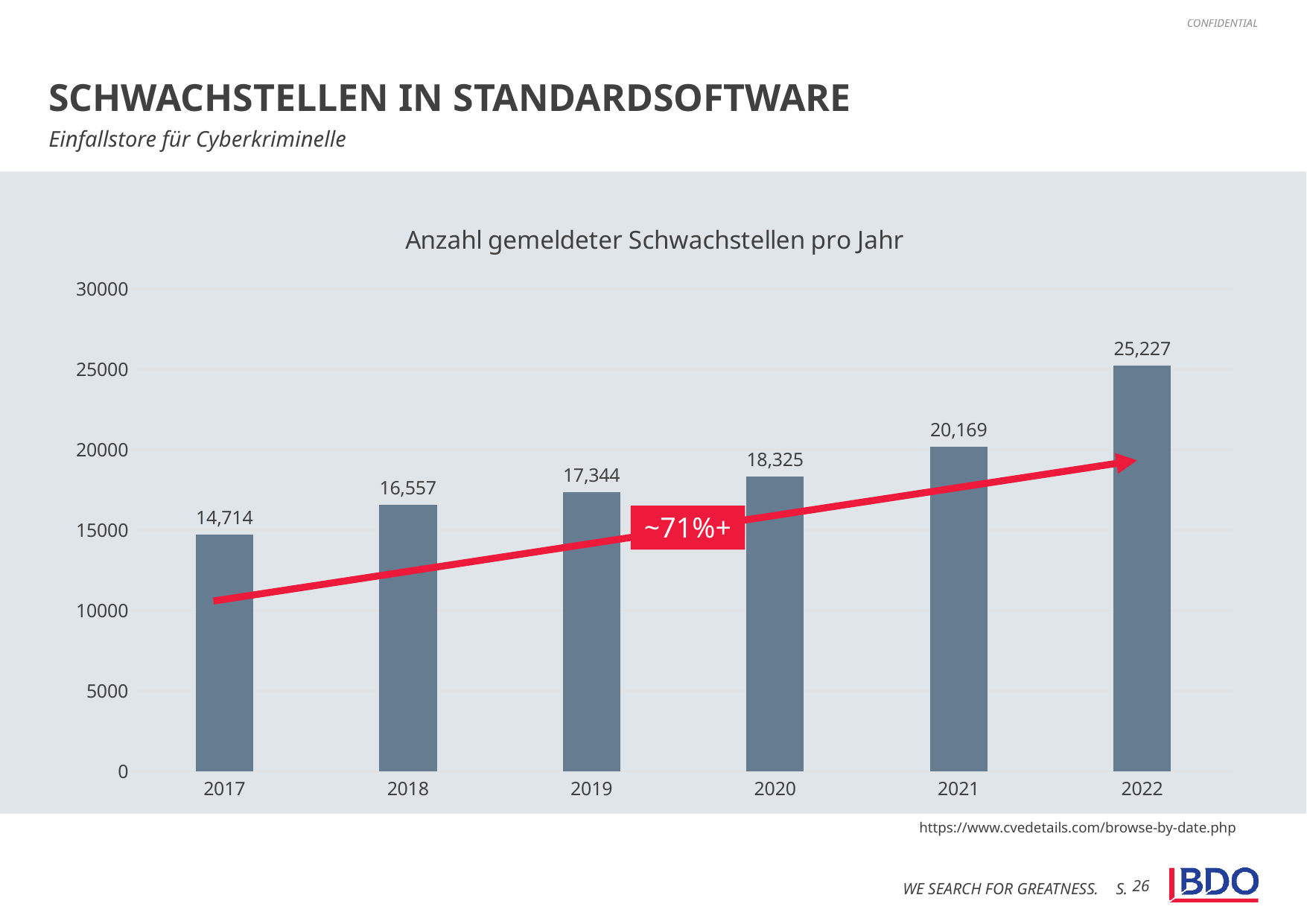
Do the values rise or fall from 2017 to 2022? Rise What is the number of reported vulnerabilities for 2017? 14,714 How many years are shown on the x axis? 6 Which year has the highest number of reported vulnerabilities? 2022 What is the difference between the values for 2022 and 2021? 5,058 Is the value for 2021 greater or less than 20000? greater What is the difference between the values for 2018 and 2017? 1,843 What is the value shown for 2020? 18,325 What kind of chart is shown on the slide? Bar chart Which year has the lowest number of reported vulnerabilities? 2017 Which year has a larger value, 2019 or 2020? 2020 What is the value shown for 2022? 25,227